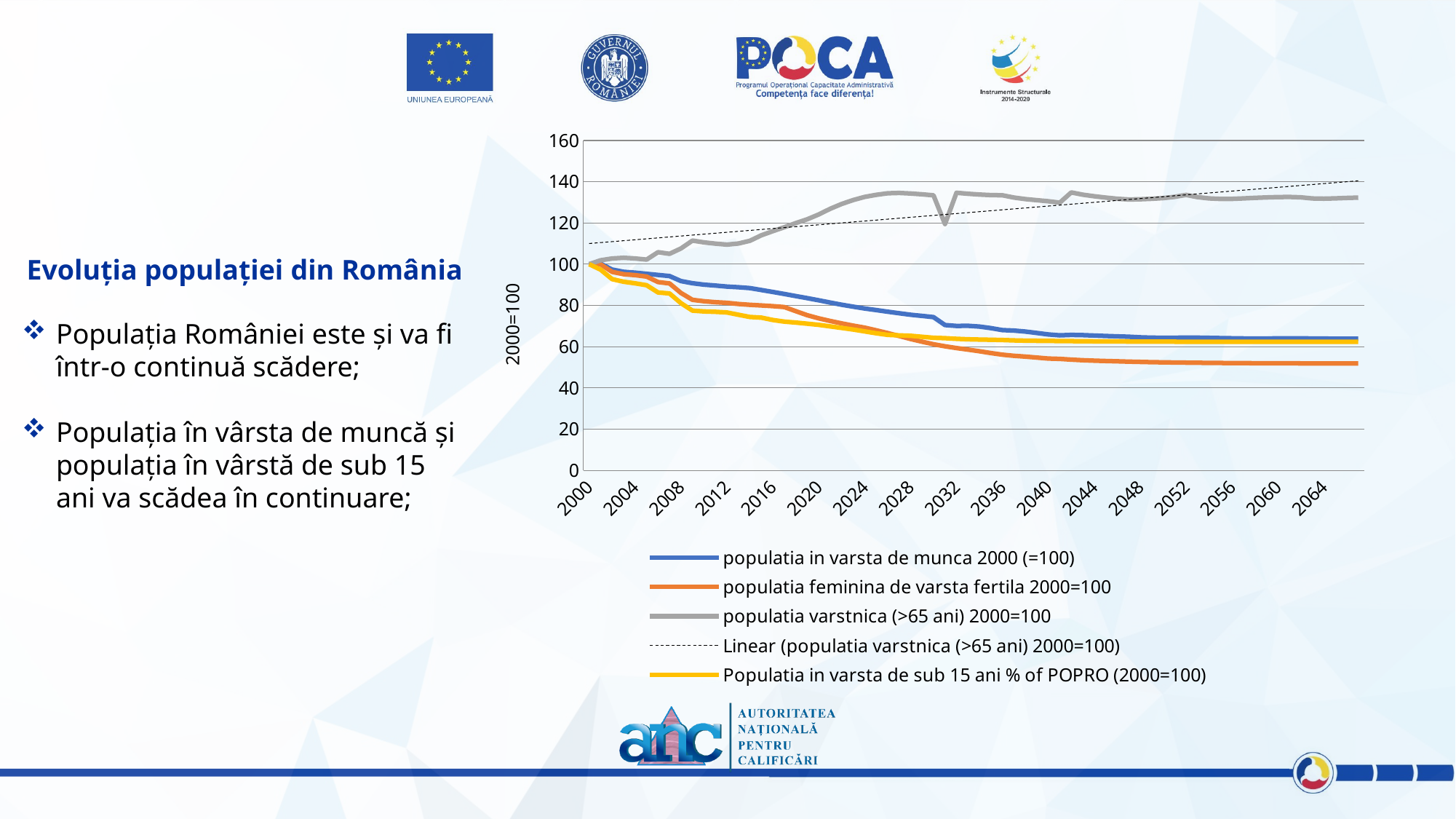
Which series has the lowest value in 2064? populatia feminina de varsta fertila 2000=100 Is the value of 'populatia in varsta de munca 2000 (=100)' in 2020 greater or less than 80? greater Does the series 'populatia feminina de varsta fertila 2000=100' rise or fall from 2000 to 2064? fall What kind of chart is shown on the slide? line chart Which legend entry is drawn as a dashed line? Linear (populatia varstnica (>65 ani) 2000=100) How many series does the chart's legend list? 5 Which series has the highest value in 2064? populatia varstnica (>65 ani) 2000=100 What is the label on the chart's vertical axis? 2000=100 Does the series 'populatia in varsta de munca 2000 (=100)' rise or fall from 2000 to 2064? fall Is the value of 'populatia varstnica (>65 ani) 2000=100' in 2028 greater or less than 120? greater Does the series 'populatia varstnica (>65 ani) 2000=100' rise or fall overall from 2000 to 2064? rise Is the value of 'populatia feminina de varsta fertila 2000=100' in 2064 greater or less than 60? less